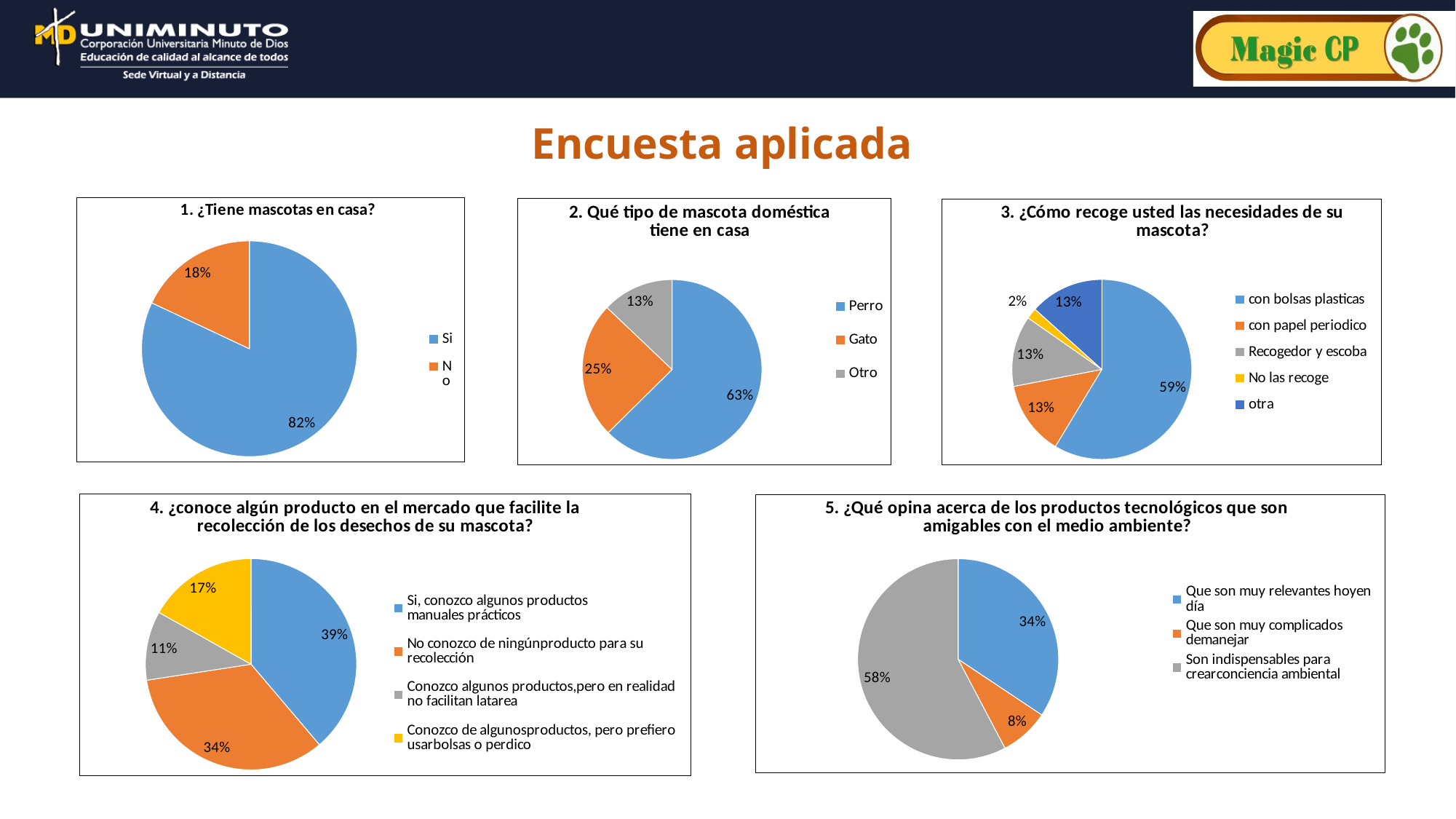
In the chart '1. ¿Tiene mascotas en casa?', what share of respondents answered Si? 82% In the chart '3. ¿Cómo recoge usted las necesidades de su mascota?', what is the share for 'con bolsas plasticas'? 59% In the chart '3. ¿Cómo recoge usted las necesidades de su mascota?', which category has the smallest share? No las recoge In the chart '1. ¿Tiene mascotas en casa?', what kind of chart is shown? Pie chart In the chart '2. Qué tipo de mascota doméstica tiene en casa', how many categories does the legend list? 3 In the chart '2. Qué tipo de mascota doméstica tiene en casa', what is the share for Gato? 25% In the chart '3. ¿Cómo recoge usted las necesidades de su mascota?', how many categories are shown in the legend? 5 In the chart '4. ¿conoce algún producto en el mercado que facilite la recolección de los desechos de su mascota?', what is the difference between the largest slice (39%) and the smallest slice (11%)? 28% In the chart '2. Qué tipo de mascota doméstica tiene en casa', which category has the largest share? Perro In the chart '5. ¿Qué opina acerca de los productos tecnológicos que son amigables con el medio ambiente?', which category has the largest share? Son indispensables para crear conciencia ambiental